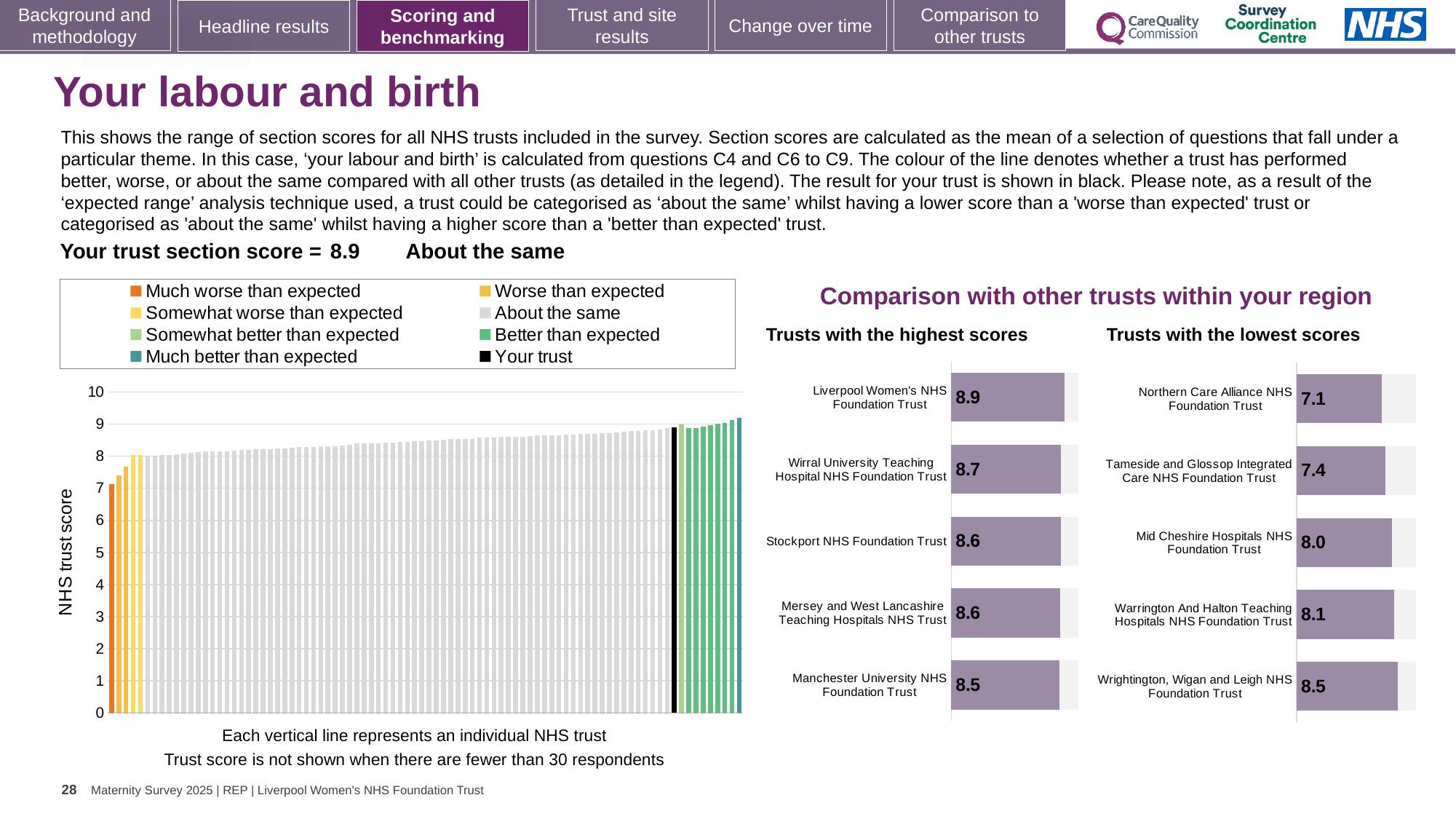
How many entries does the legend above the left-hand chart list? 8 In the 'Trusts with the lowest scores' chart, which has the larger score: Mid Cheshire Hospitals NHS Foundation Trust or Warrington And Halton Teaching Hospitals NHS Foundation Trust? Warrington And Halton Teaching Hospitals NHS Foundation Trust In the 'Trusts with the highest scores' chart, which trust has the highest score? Liverpool Women's NHS Foundation Trust In the 'Trusts with the highest scores' chart, what is the difference between the scores of Liverpool Women's NHS Foundation Trust and Manchester University NHS Foundation Trust? 0.4 What is the label on the vertical axis of the left-hand chart? NHS trust score In the 'Trusts with the lowest scores' chart, how much higher is Tameside and Glossop Integrated Care NHS Foundation Trust's score than Northern Care Alliance NHS Foundation Trust's? 0.3 In the 'Trusts with the highest scores' chart, what is the score for Wirral University Teaching Hospital NHS Foundation Trust? 8.7 In the 'Trusts with the lowest scores' chart, which trust has the lowest score? Northern Care Alliance NHS Foundation Trust How many trusts are listed in the 'Trusts with the highest scores' chart? 5 In the left-hand chart of NHS trust scores, do the values rise or fall from left to right? Rise In the 'Trusts with the lowest scores' chart, what is the score for Northern Care Alliance NHS Foundation Trust? 7.1 What kind of chart is the large chart on the left showing NHS trust scores? Bar chart